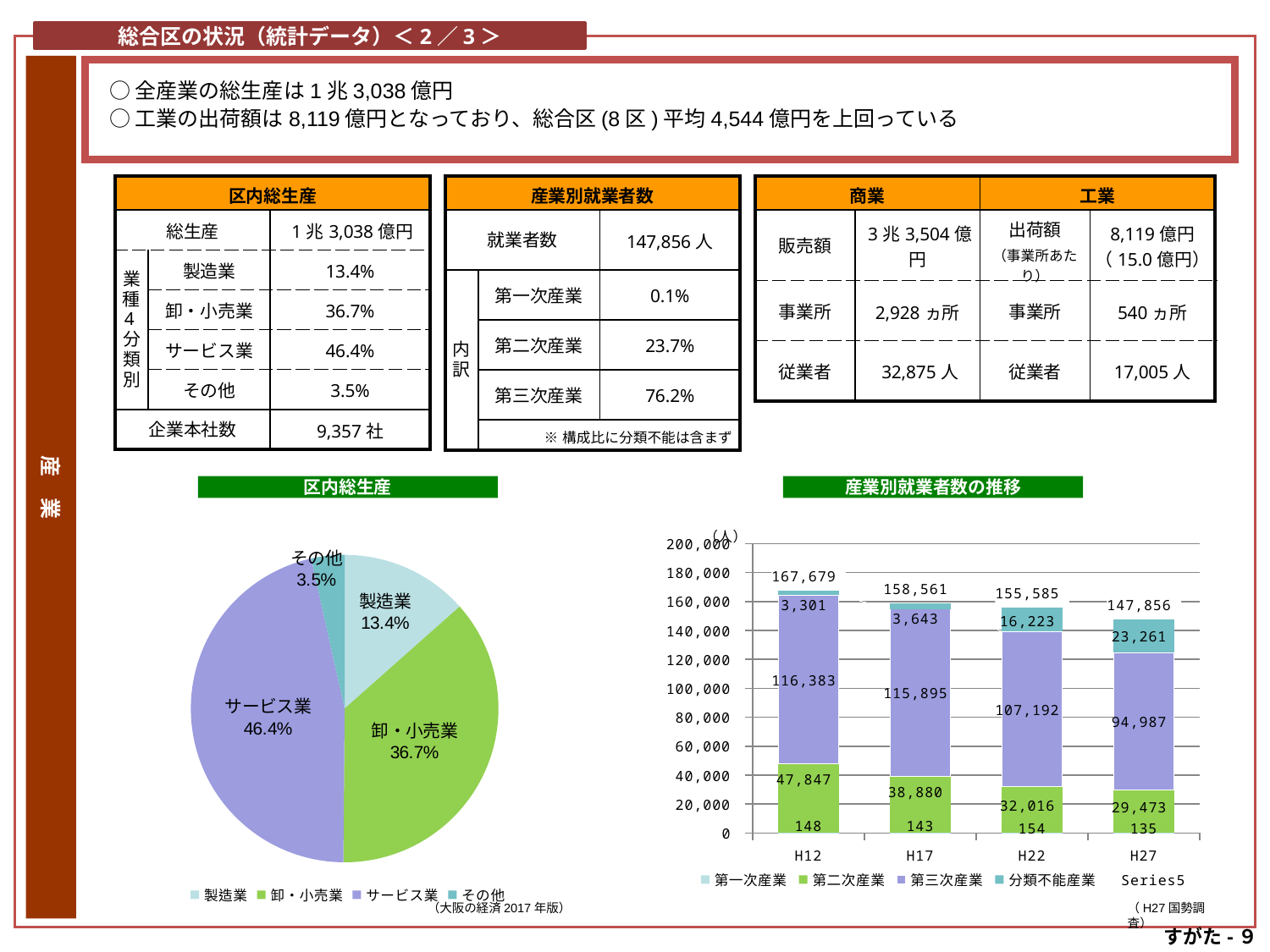
In the 産業別就業者数の推移 chart, do the bar totals rise or fall from H12 to H27? Fall In the 産業別就業者数の推移 chart, what is the total for H12? 167,679 In the 産業別就業者数の推移 chart, what is the value of 第二次産業 for H17? 38,880 What kind of chart is the 区内総生産 chart? Pie chart In the 区内総生産 pie chart, which category has the smallest share? その他 How many entries does the legend of the 産業別就業者数の推移 chart list? 5 In the 産業別就業者数の推移 chart, which is larger: 分類不能産業 for H22 or for H27? H27 In the 区内総生産 pie chart, which category has the largest share? サービス業 In the 産業別就業者数の推移 chart, what is the value of 第三次産業 for H27? 94,987 In the 区内総生産 pie chart, what share does サービス業 have? 46.4% In the 区内総生産 pie chart, what is the value for 製造業? 13.4% In the 区内総生産 pie chart, what is the difference between the shares of サービス業 and 卸・小売業? 9.7%